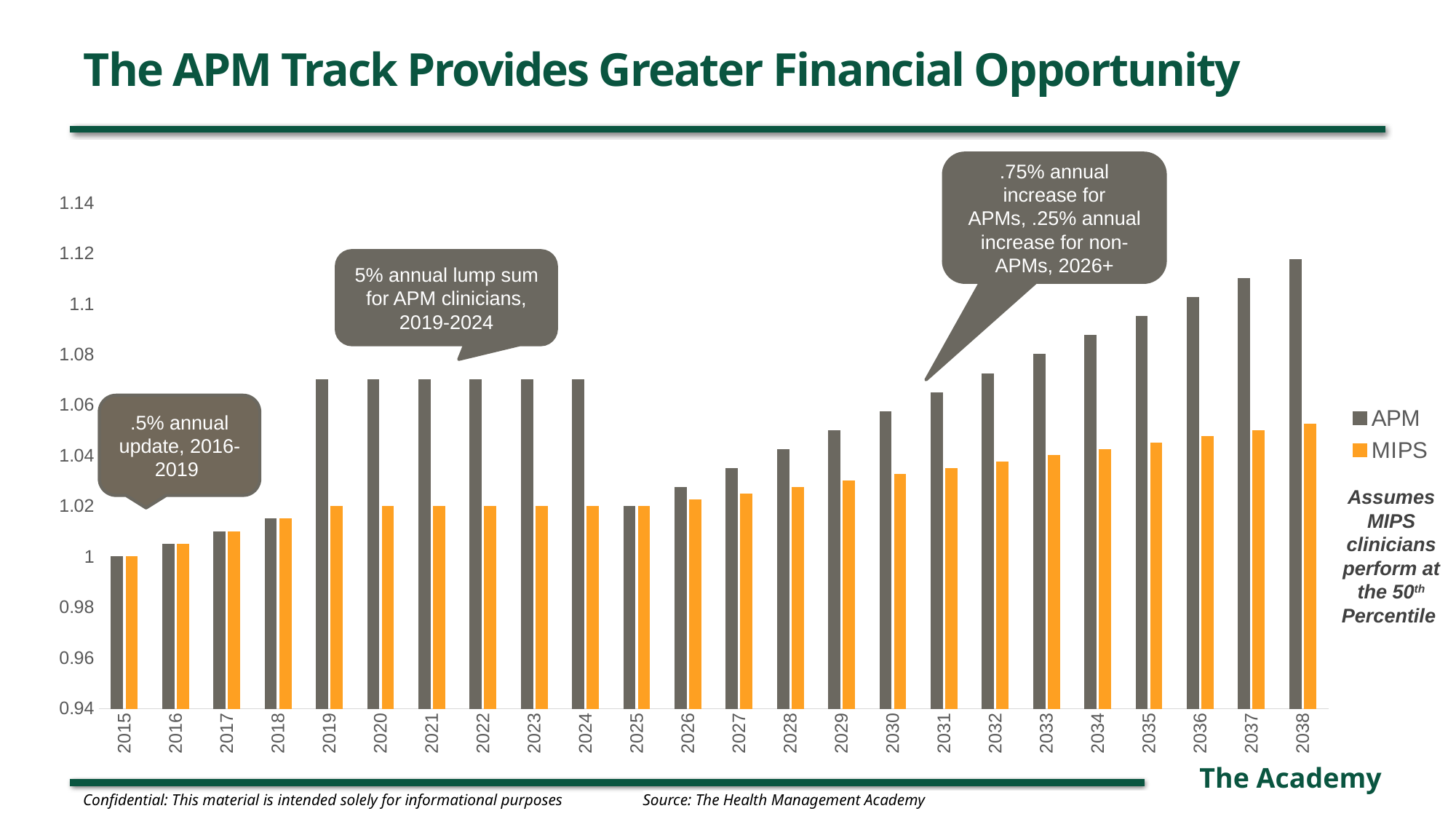
What kind of chart is shown on the slide? bar chart Is the MIPS value for 2038 greater or less than 1.04? greater What are the two series named in the legend? APM and MIPS How many years are shown along the x axis? 24 In 2024, which series has the larger value, APM or MIPS? APM Is the APM value for 2038 greater or less than 1.1? greater Is the MIPS value for 2030 greater or less than 1.04? less Which year has the highest APM value? 2038 How many series does the legend list? 2 Do the MIPS values rise or fall from 2026 to 2038? rise Which year has the lowest MIPS value? 2015